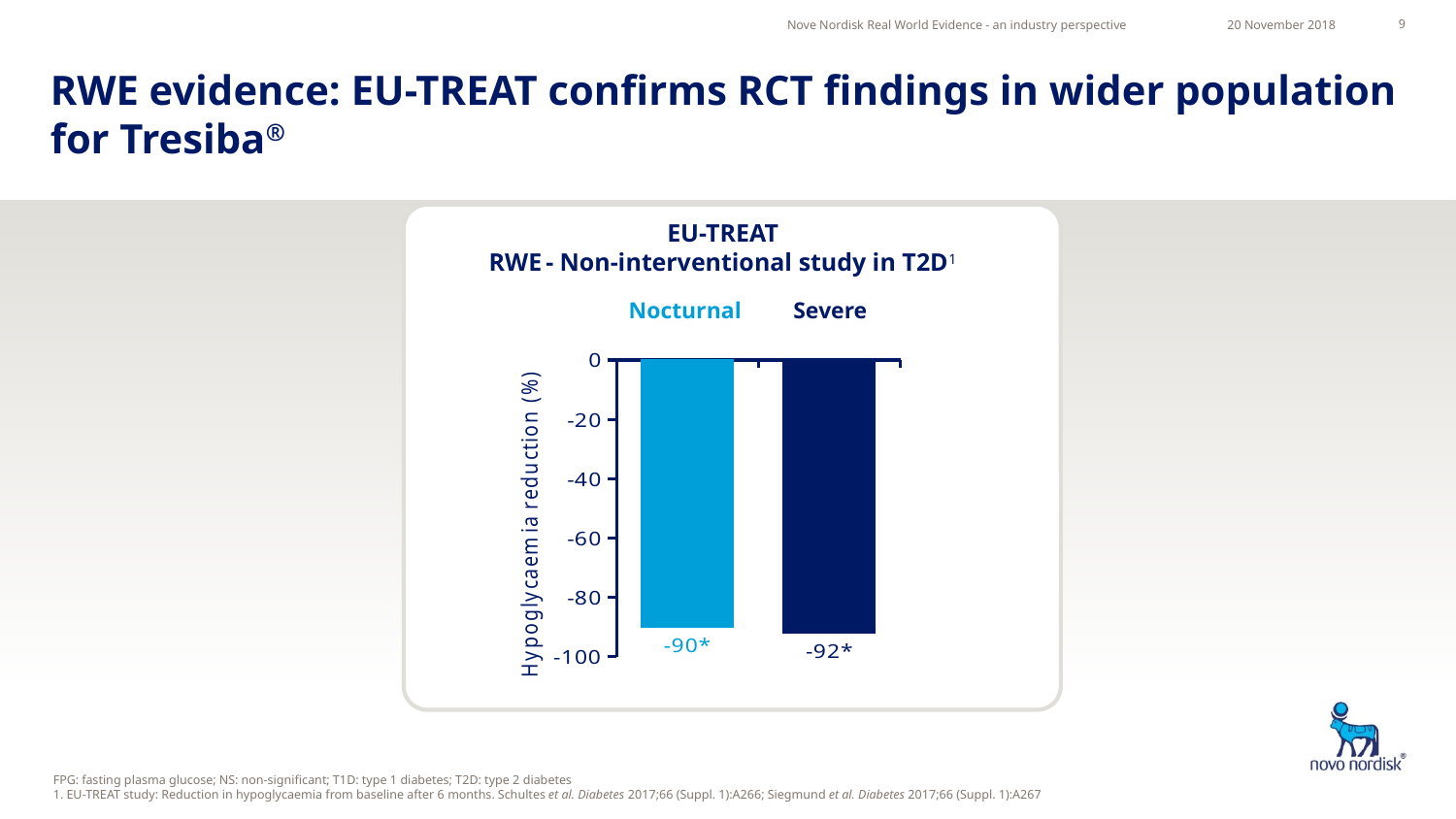
Is the value for Nocturnal greater or less than -80? less What kind of chart is shown on the slide? Bar chart Which category shows the larger reduction in hypoglycaemia, Nocturnal or Severe? Severe What is the data label on the Severe bar? -92* What is the data label on the Nocturnal bar? -90* What is the label of the vertical axis? Hypoglycaemia reduction (%) What is the title of the chart? EU-TREAT RWE - Non-interventional study in T2D Which category has the lowest (most negative) value on the chart? Severe Which category has the highest (least negative) value on the chart? Nocturnal What is the difference in percentage points between the Nocturnal and Severe values? 2 How many categories are plotted on the chart? 2